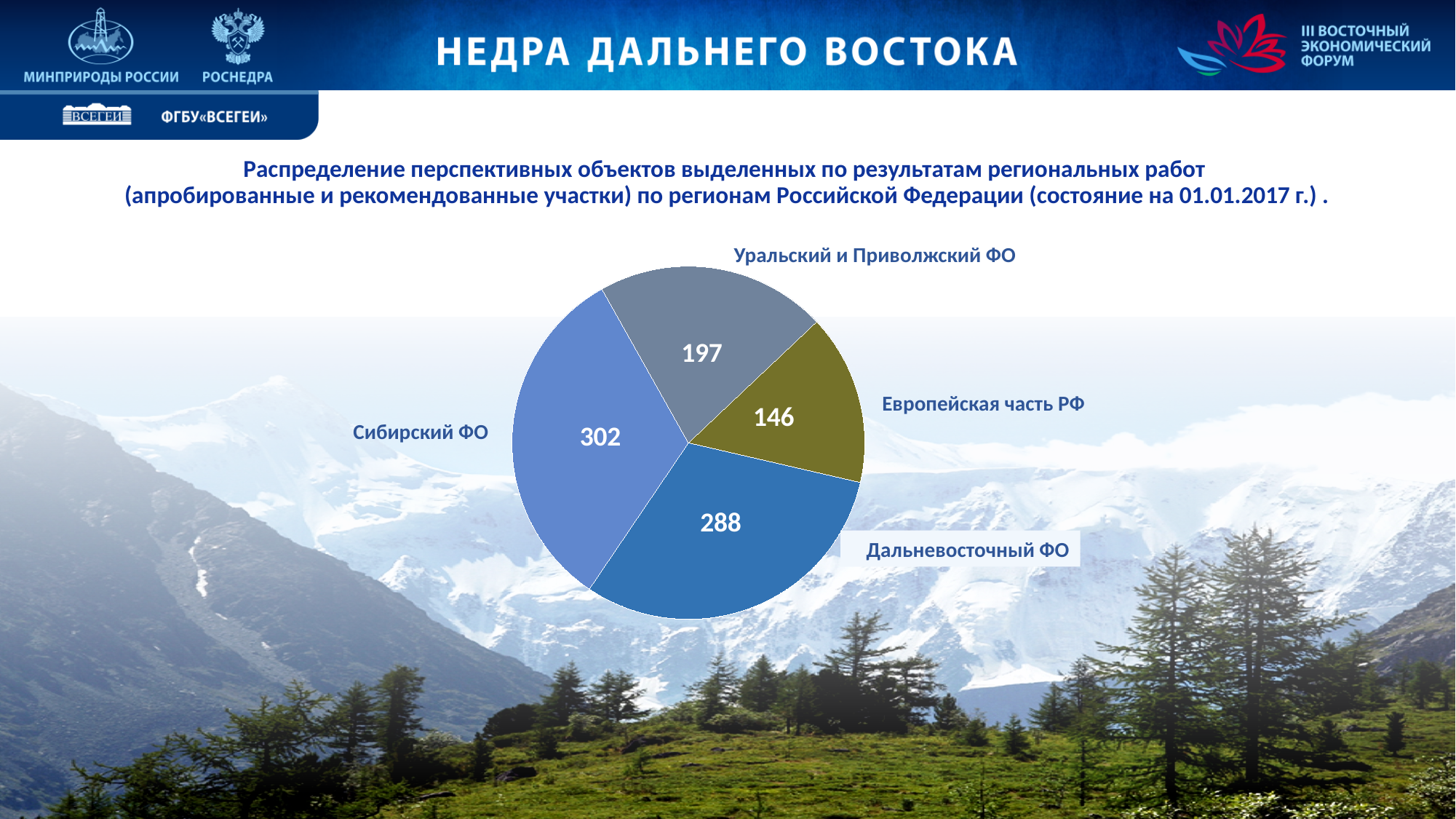
Which is larger, the value for Дальневосточный ФО or the value for Уральский и Приволжский ФО? Дальневосточный ФО What is the value for Сибирский ФО? 302 Which region has the largest slice of the pie? Сибирский ФО What type of chart is shown on the slide? pie chart What is the difference between the values for Сибирский ФО and Дальневосточный ФО? 14 What is the value for Европейская часть РФ? 146 What is the total of all four slices in the pie chart? 933 What is the difference between the values for Уральский и Приволжский ФО and Европейская часть РФ? 51 How many slices does the pie chart have? 4 What is the value for Дальневосточный ФО? 288 What is the value for Уральский и Приволжский ФО? 197 Which region has the smallest slice of the pie? Европейская часть РФ